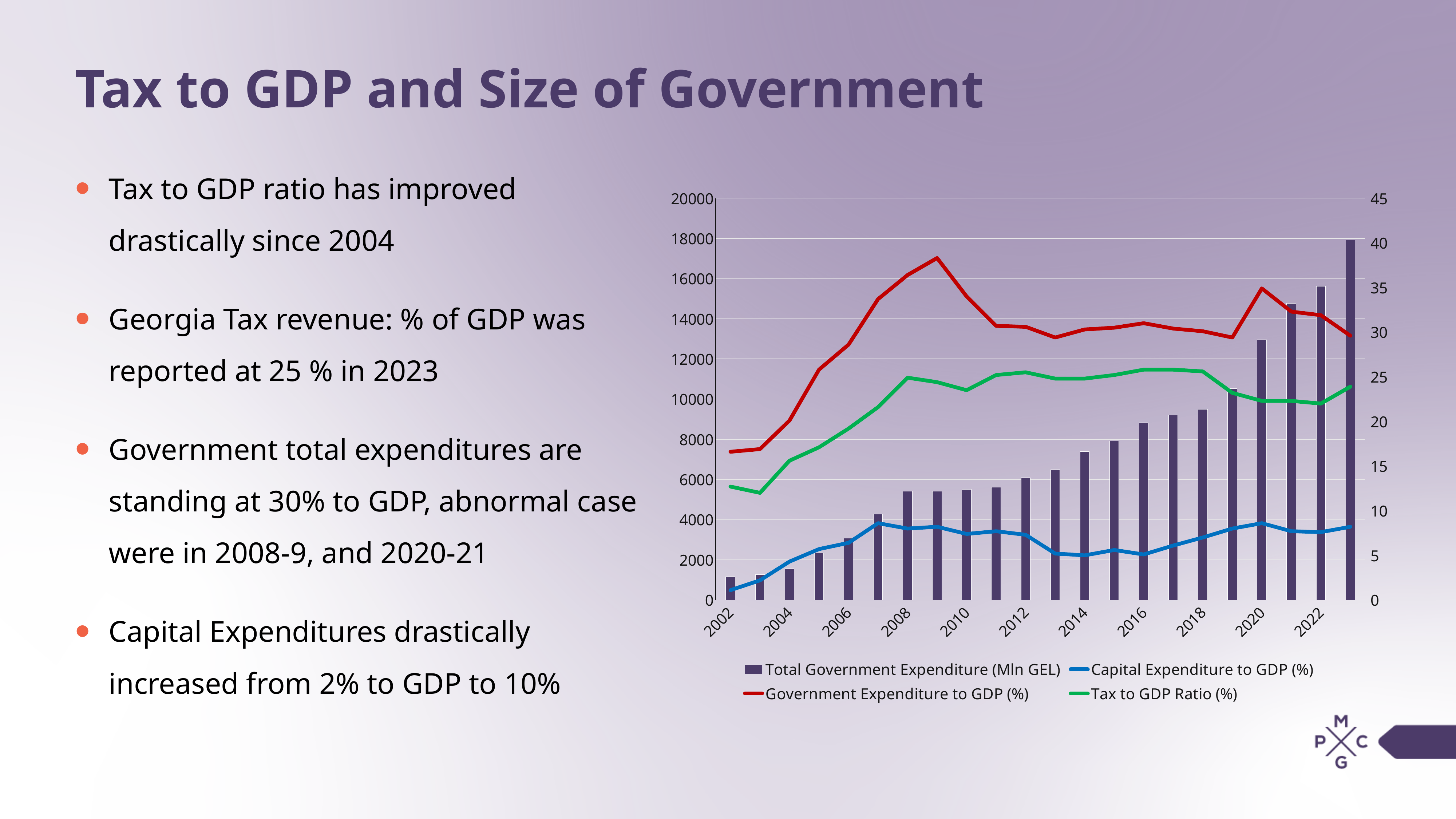
In which year is the Total Government Expenditure (Mln GEL) bar the lowest? 2002 What colour is the Tax to GDP Ratio (%) line in the chart? Green Overall, do the Total Government Expenditure (Mln GEL) bars rise or fall from 2002 to 2023? Rise What kind of chart is shown on the slide? A combined bar and line chart In which year does the Government Expenditure to GDP (%) line reach its peak? 2009 Which is larger, the Total Government Expenditure (Mln GEL) bar for 2020 or for 2019? 2020 In which year is the Total Government Expenditure (Mln GEL) bar the highest? 2023 How many series does the chart legend list? 4 Is the Government Expenditure to GDP (%) value for 2009 greater or less than 35? greater Is the Total Government Expenditure (Mln GEL) value for 2023 greater or less than 16000? greater Is the Total Government Expenditure (Mln GEL) value for 2002 greater or less than 2000? less Which series in the chart is plotted as bars? Total Government Expenditure (Mln GEL)